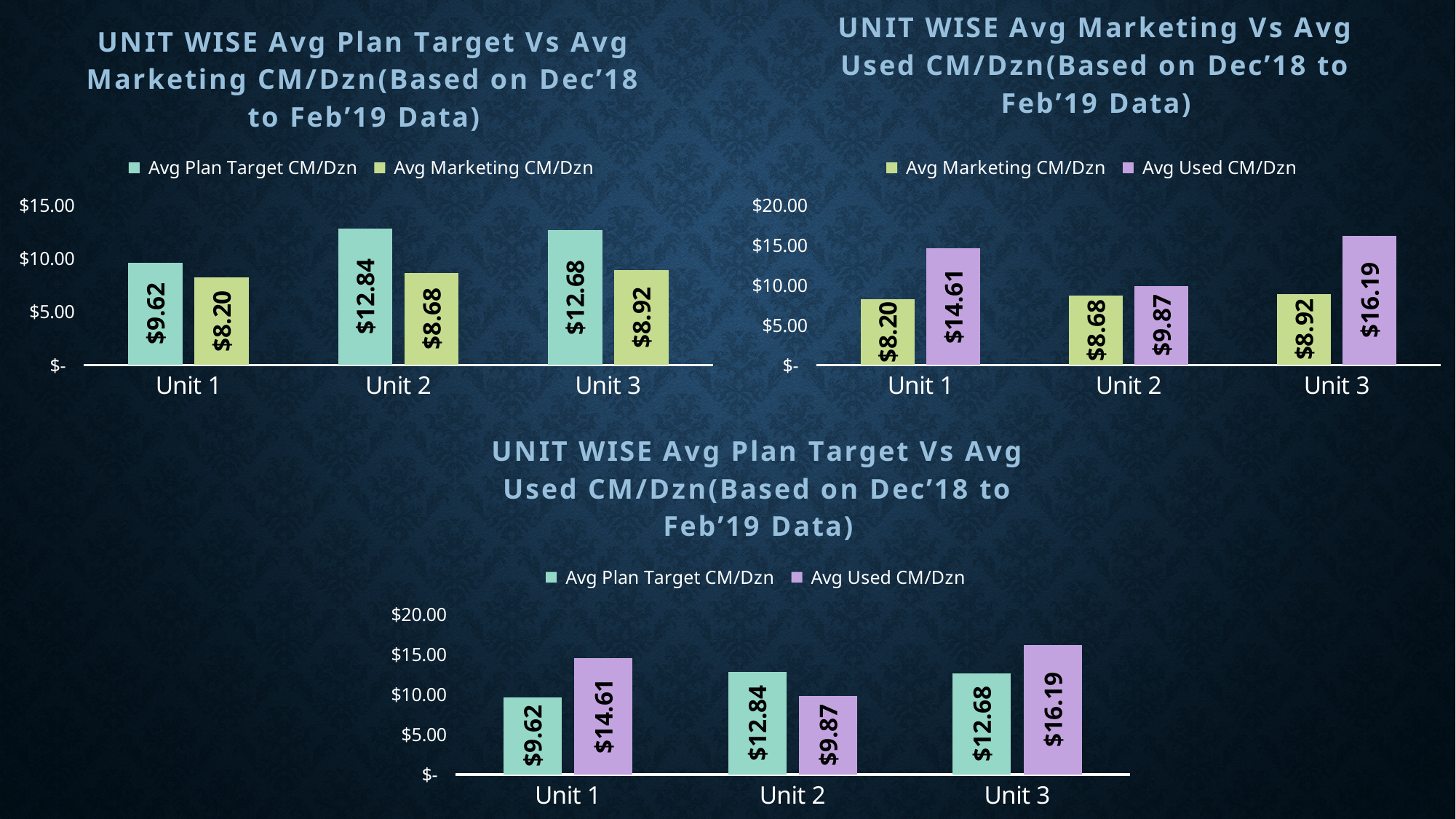
In the top-right chart (Avg Marketing Vs Avg Used), how many series does the legend list? 2 In the bottom chart (Avg Plan Target Vs Avg Used), what is the difference between the Avg Used and Avg Plan Target CM/Dzn for Unit 3? $3.51 In the top-right chart (Avg Marketing Vs Avg Used), is the Avg Used CM/Dzn for Unit 2 greater or less than the Avg Marketing CM/Dzn for Unit 2? greater What type of chart is the bottom chart (Avg Plan Target Vs Avg Used)? Bar chart In the top-right chart (Avg Marketing Vs Avg Used), what is the Avg Used CM/Dzn for Unit 1? $14.61 In the top-right chart (Avg Marketing Vs Avg Used), which unit has the highest Avg Used CM/Dzn? Unit 3 In the top-left chart (Avg Plan Target Vs Avg Marketing), what is the difference between the Avg Plan Target and Avg Marketing CM/Dzn for Unit 1? $1.42 In the bottom chart (Avg Plan Target Vs Avg Used), what is the Avg Used CM/Dzn for Unit 2? $9.87 In the bottom chart (Avg Plan Target Vs Avg Used), how many units are shown on the x axis? 3 In the top-left chart (Avg Plan Target Vs Avg Marketing), what is the Avg Plan Target CM/Dzn for Unit 2? $12.84 In the top-left chart (Avg Plan Target Vs Avg Marketing), which unit has the lowest Avg Plan Target CM/Dzn? Unit 1 In the top-left chart (Avg Plan Target Vs Avg Marketing), what is the Avg Marketing CM/Dzn for Unit 3? $8.92